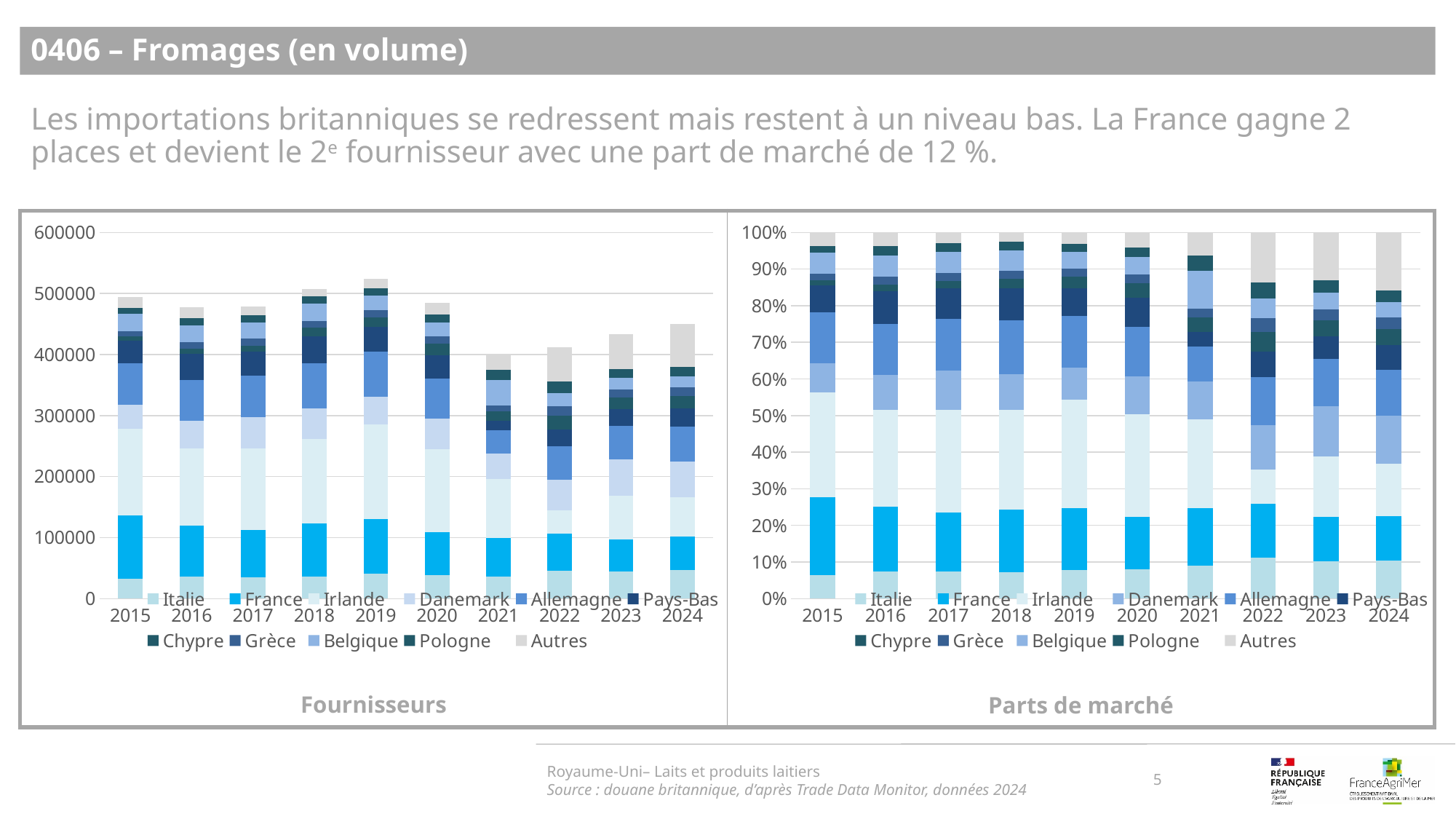
In the Parts de marché chart, does the share of Autres rise or fall from 2015 to 2024? rises In the Fournisseurs chart, is the total for 2019 greater or less than 500000? greater How many series does the legend of the Parts de marché chart list? 11 In the Fournisseurs chart, is the total for 2019 larger than the total for 2021? yes In the Fournisseurs chart, is the total for 2016 greater or less than 400000? greater How many years are shown on the x axis of the Fournisseurs chart? 10 In the Fournisseurs chart, which year has the highest total bar? 2019 What kind of chart is the Fournisseurs chart on the left? stacked bar chart In the Fournisseurs chart, is the total for 2023 greater or less than 500000? less What is the title of the chart on the right? Parts de marché Which series is listed first in the legend of the Fournisseurs chart? Italie